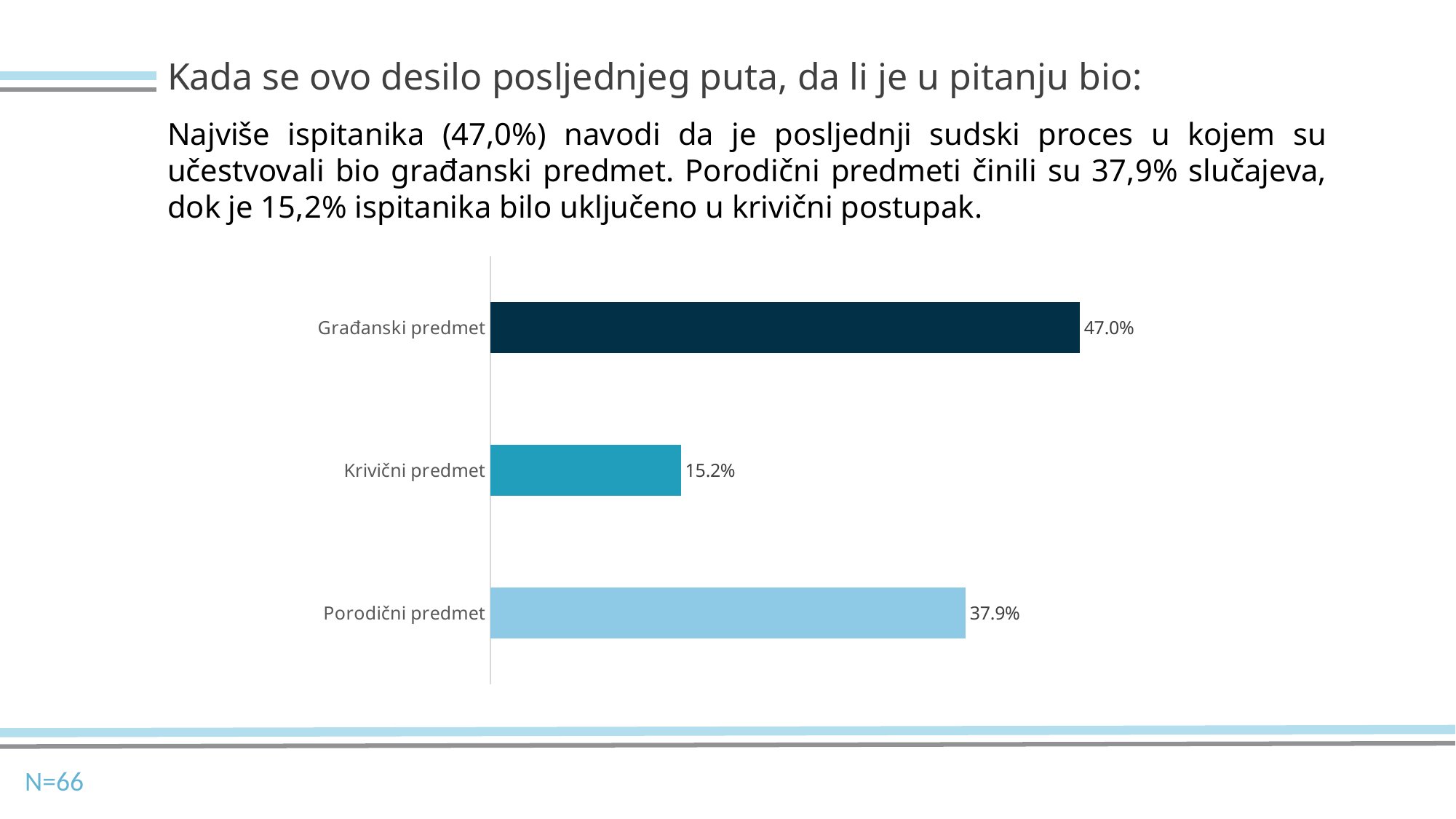
What kind of chart is shown on the slide? bar chart How many categories are shown in the chart? 3 What is the sample size (N) shown on the slide? N=66 Which category's bar is the darkest in colour? Građanski predmet Which category has the highest value? Građanski predmet What is the value for Krivični predmet? 15.2% What is the difference between the values for Građanski predmet and Porodični predmet? 9.1% What is the value for Građanski predmet? 47.0% Which category has the lowest value? Krivični predmet Which is larger, the value for Porodični predmet or the value for Krivični predmet? Porodični predmet What is the difference between the values for Porodični predmet and Krivični predmet? 22.7% What is the value for Porodični predmet? 37.9%